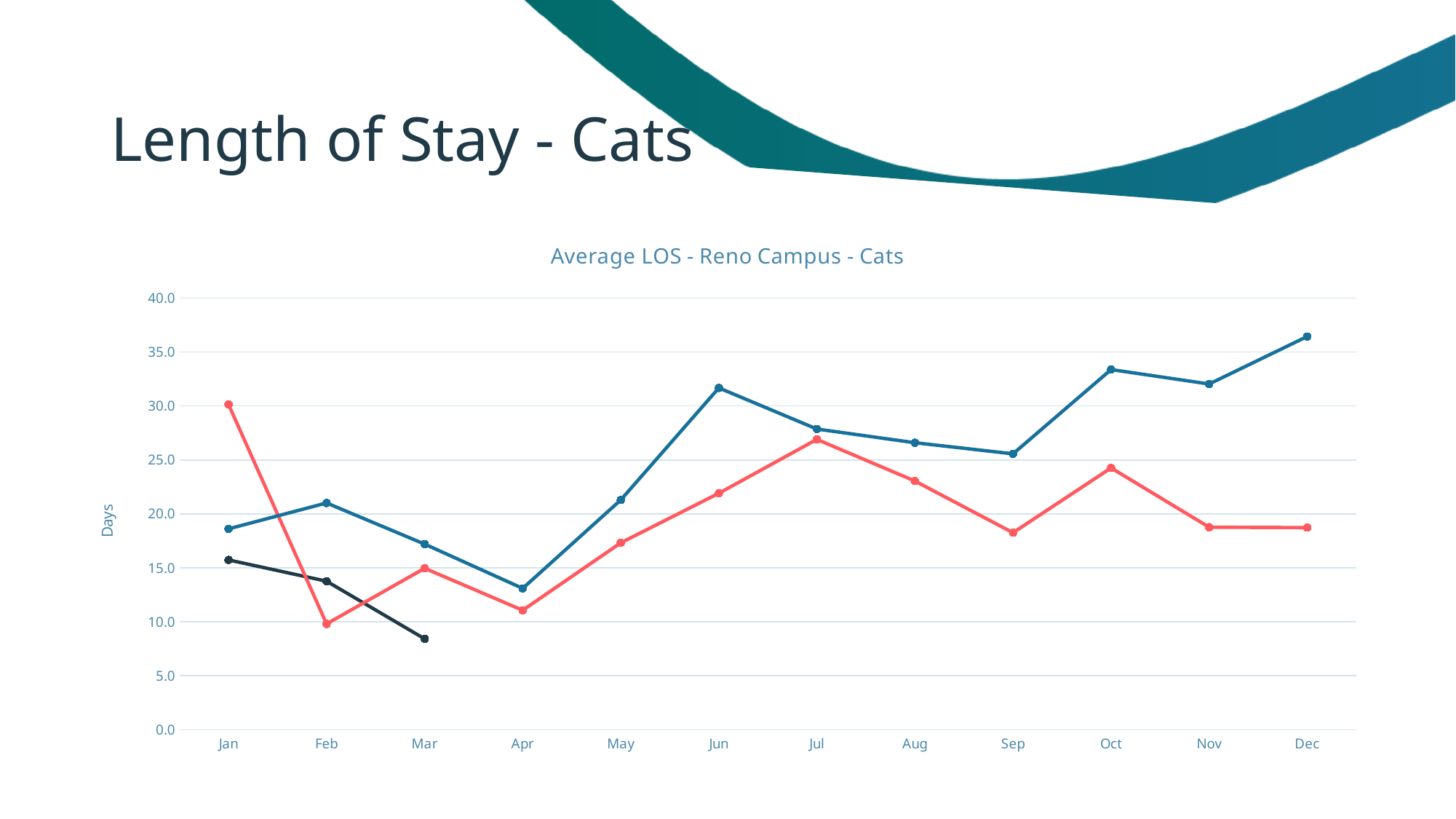
What is the title of the chart? Average LOS - Reno Campus - Cats Is the value of the black line in Mar greater or less than 10.0? less In which month does the blue line reach its lowest value? Apr What is the label on the vertical axis of the chart? Days What type of chart is shown on the slide? Line chart How many months are shown along the x axis of the chart? 12 Is the value of the blue line in Jun greater or less than 30.0? greater Is the value of the blue line in Apr greater or less than 15.0? less In Jun, which line has the higher value, the blue line or the red line? Blue line In which month does the blue line reach its highest value? Dec In which month does the red line reach its highest value? Jan